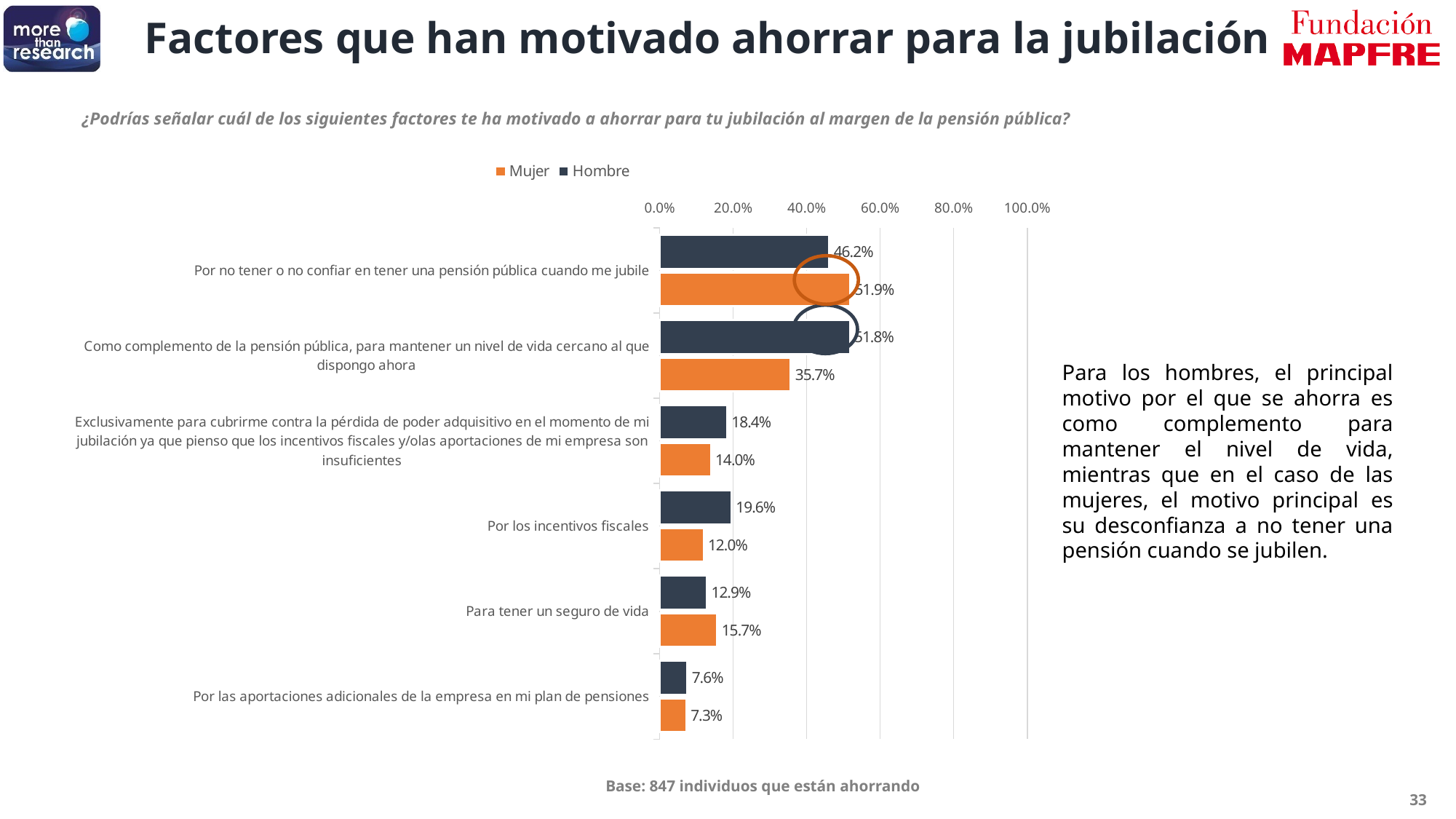
Is the Hombre value for "Como complemento de la pensión pública..." greater or less than 40.0%? greater What is the difference between the Hombre and Mujer values for "Por los incentivos fiscales"? 7.6% Which category has the highest Mujer value? Por no tener o no confiar en tener una pensión pública cuando me jubile What is the Hombre value for "Por los incentivos fiscales"? 19.6% What is the Mujer value for "Como complemento de la pensión pública, para mantener un nivel de vida cercano al que dispongo ahora"? 35.7% For "Exclusivamente para cubrirme contra la pérdida de poder adquisitivo...", which series has the larger value, Mujer or Hombre? Hombre What is the Mujer value for "Para tener un seguro de vida"? 15.7% Which category has the lowest Hombre value? Por las aportaciones adicionales de la empresa en mi plan de pensiones How many categories are shown in the chart? 6 How many series does the legend list? 2 What type of chart is shown on the slide? Bar chart What is the Hombre value for "Por las aportaciones adicionales de la empresa en mi plan de pensiones"? 7.6%